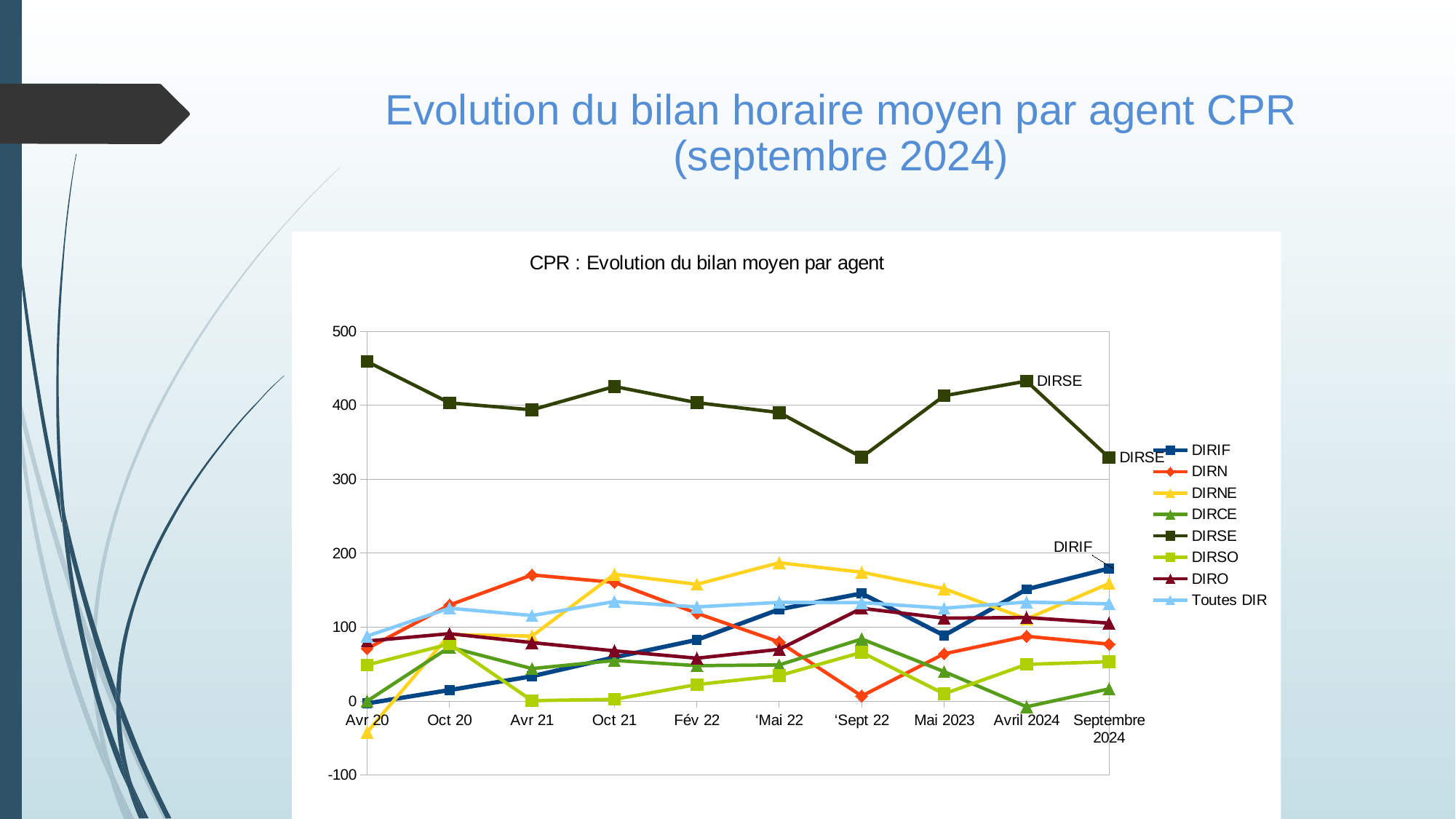
What kind of chart is shown on the slide? line chart Is the value for DIRNE at Avr 20 greater or less than 0? less How many time points are shown along the x axis? 10 Is the value for DIRIF at Septembre 2024 greater or less than 100? greater Is the value for DIRSE at Avr 20 greater or less than 400? greater How many series does the legend list? 8 Which series has the highest value at Avr 20? DIRSE Does the DIRIF series rise or fall overall from Avr 20 to Septembre 2024? rises What is the title printed above the chart? CPR : Evolution du bilan moyen par agent Which series has the lowest value at Avr 20? DIRNE At Septembre 2024, which is larger: the value for DIRIF or the value for DIRN? DIRIF